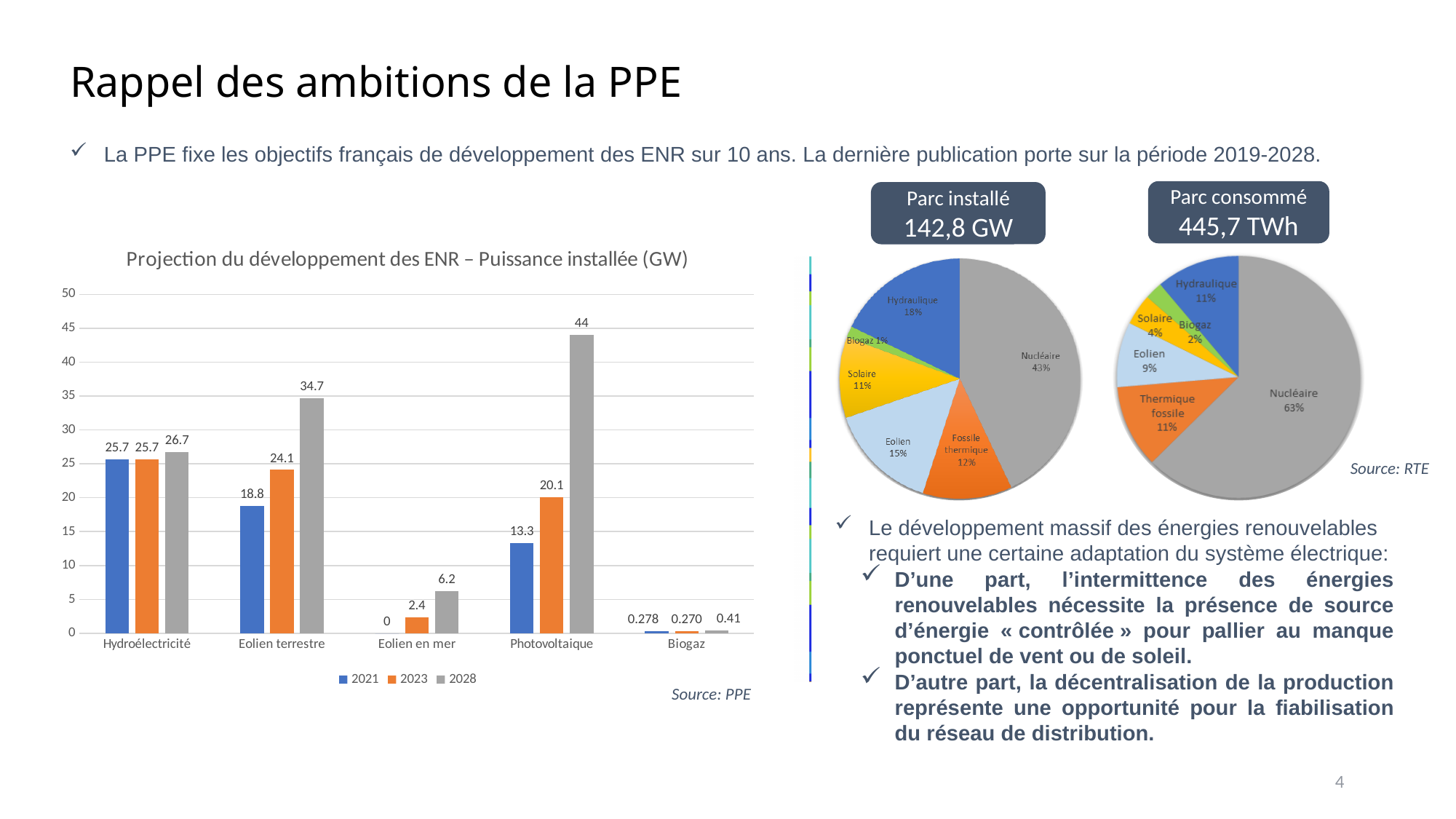
In the bar chart 'Projection du développement des ENR – Puissance installée (GW)', which category has the highest value in 2028? Photovoltaique How many categories are shown on the x axis of the bar chart 'Projection du développement des ENR – Puissance installée (GW)'? 5 What kind of chart is 'Parc consommé 445,7 TWh'? pie chart In the bar chart 'Projection du développement des ENR – Puissance installée (GW)', do the values for Photovoltaique rise or fall from 2021 to 2028? rise How many series does the legend of the bar chart 'Projection du développement des ENR – Puissance installée (GW)' list? 3 In the pie chart 'Parc installé 142,8 GW', what share does Nucléaire have? 43% In the bar chart 'Projection du développement des ENR – Puissance installée (GW)', which category has the lowest value in 2021? Eolien en mer In the pie chart 'Parc consommé 445,7 TWh', what share does Eolien have? 9% In the bar chart 'Projection du développement des ENR – Puissance installée (GW)', what is the value for Photovoltaique in 2028? 44 In the bar chart 'Projection du développement des ENR – Puissance installée (GW)', which is larger: Hydroélectricité in 2028 or Photovoltaique in 2023? Hydroélectricité in 2028 In the bar chart 'Projection du développement des ENR – Puissance installée (GW)', what is the difference between the 2028 and 2021 values for Eolien terrestre? 15.9 In the bar chart 'Projection du développement des ENR – Puissance installée (GW)', what is the value for Eolien terrestre in 2023? 24.1